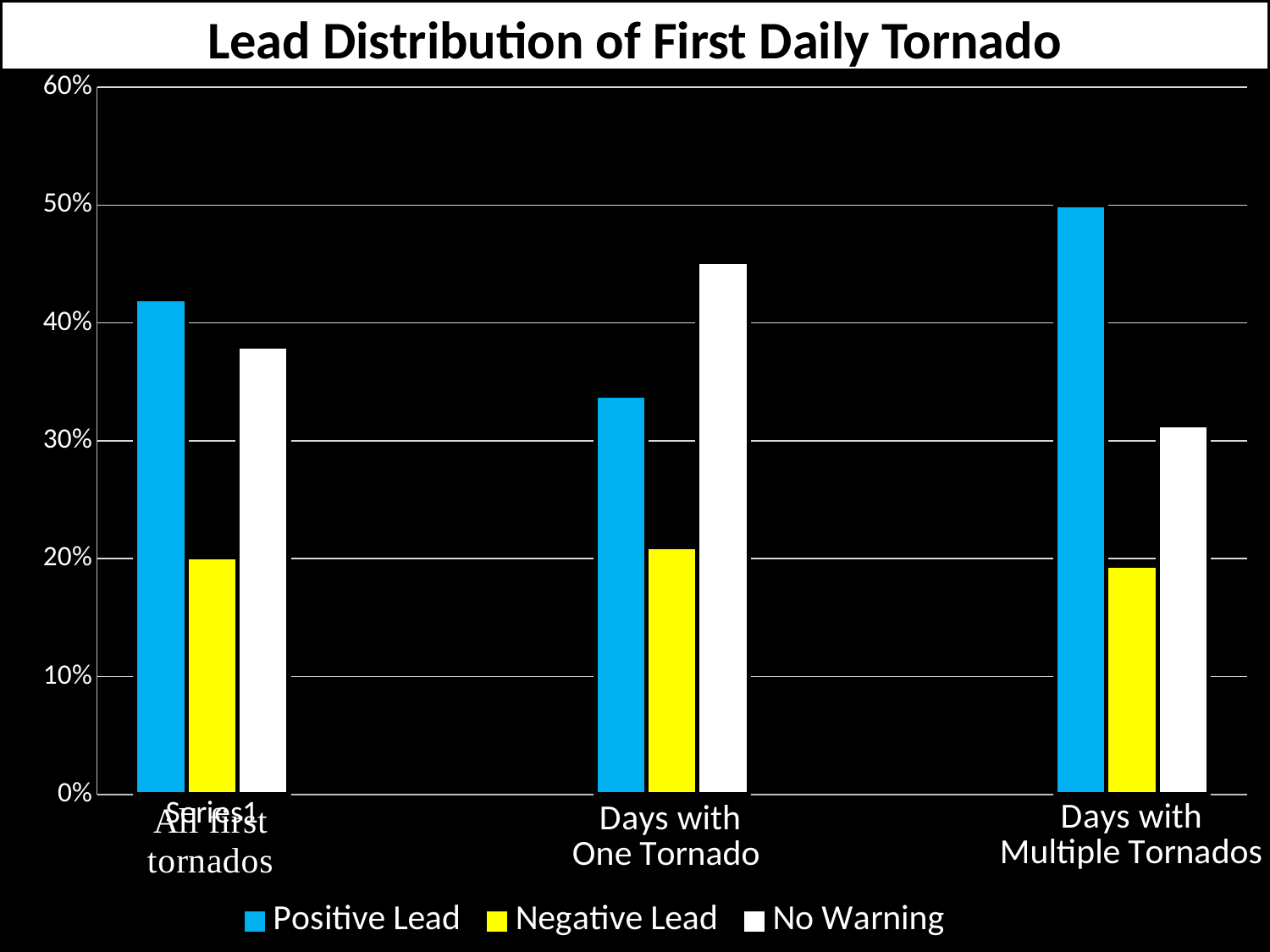
Which series has the lowest value for Days with Multiple Tornados? Negative Lead Is the Positive Lead value for Days with Multiple Tornados greater or less than 40%? greater What kind of chart is shown on the slide? bar chart For All first tornados, which is larger: Positive Lead or No Warning? Positive Lead Is the Positive Lead value for Days with One Tornado greater or less than 40%? less What colour represents the Negative Lead series? yellow Is the No Warning value for Days with One Tornado greater or less than 40%? greater How many categories are shown on the x axis? 3 Which series has the highest value for Days with One Tornado? No Warning How many series does the legend list? 3 Which category has the highest Positive Lead value? Days with Multiple Tornados